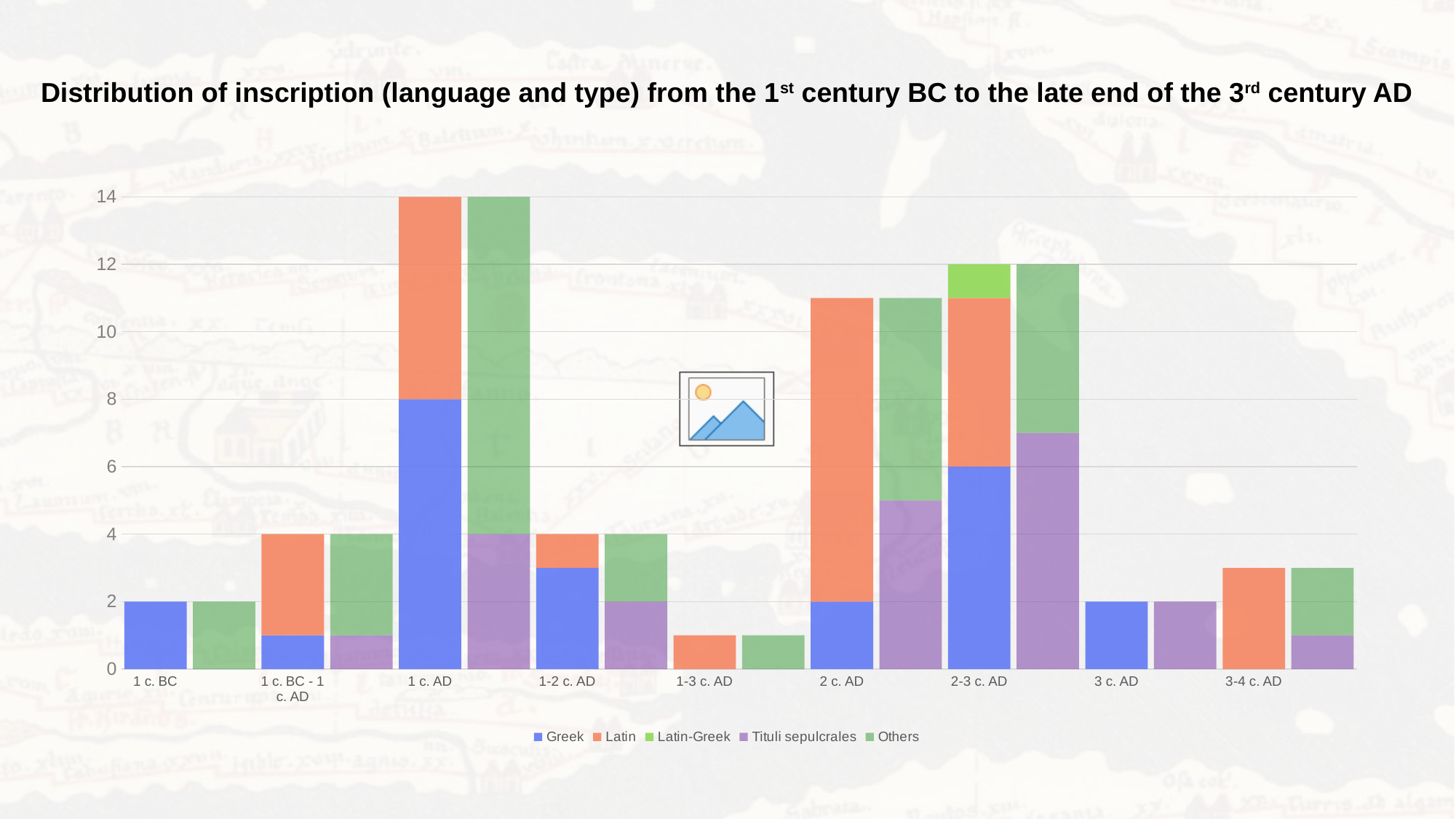
Is the total of the Latin and Greek bar for 2 c. AD greater or less than 10? greater What is the value for Greek in 2-3 c. AD? 6 Which period has the tallest bar? 1 c. AD What is the value for Greek in 1 c. BC? 2 What is the total height of the language bar (Greek + Latin) for 1 c. AD? 14 Which is larger, the Greek value in 1 c. AD or the Greek value in 2-3 c. AD? 1 c. AD How many series does the legend list? 5 Is the total of the bar for 3-4 c. AD greater or less than 4? less What is the value for Greek in 1 c. AD? 8 How many period categories are shown on the x axis? 9 Which period has the shortest bars? 1-3 c. AD What kind of chart is shown on the slide? stacked bar chart